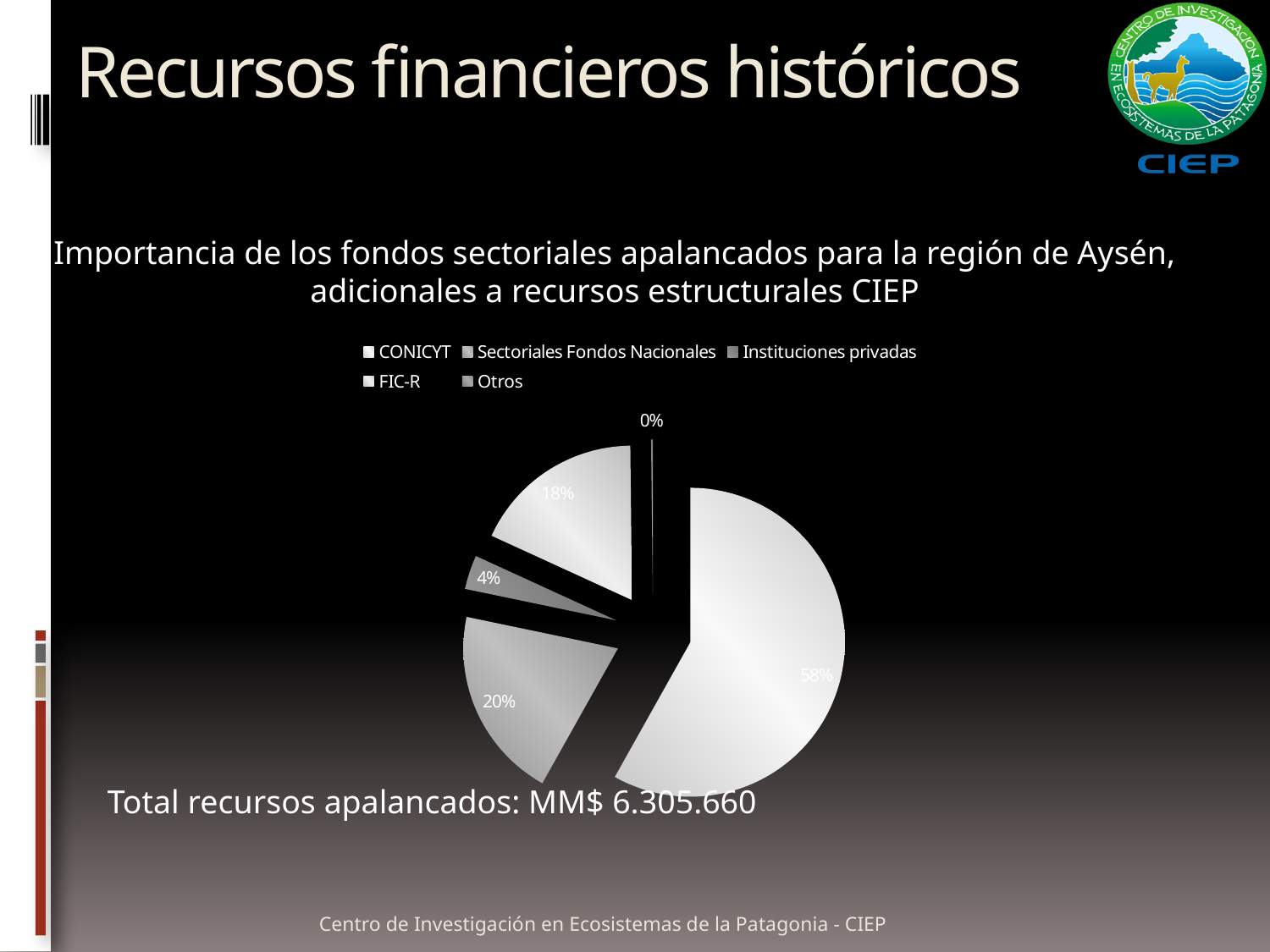
What share of the pie does Instituciones privadas represent? 4% Which legend entry is listed first in the pie chart's legend? CONICYT Which is larger, the slice for Sectoriales Fondos Nacionales or the slice for FIC-R? Sectoriales Fondos Nacionales What is the percentage of the smallest slice in the pie chart? 0% What total of leveraged resources (Total recursos apalancados) is stated below the chart? MM$ 6.305.660 What share of the pie does FIC-R represent? 18% What share of the pie does Sectoriales Fondos Nacionales represent? 20% What is the percentage of the largest slice in the pie chart? 58% What kind of chart is shown on the slide? pie chart What is the difference in percentage points between the 58% slice and the 20% slice? 38 How many categories does the pie chart's legend list? 5